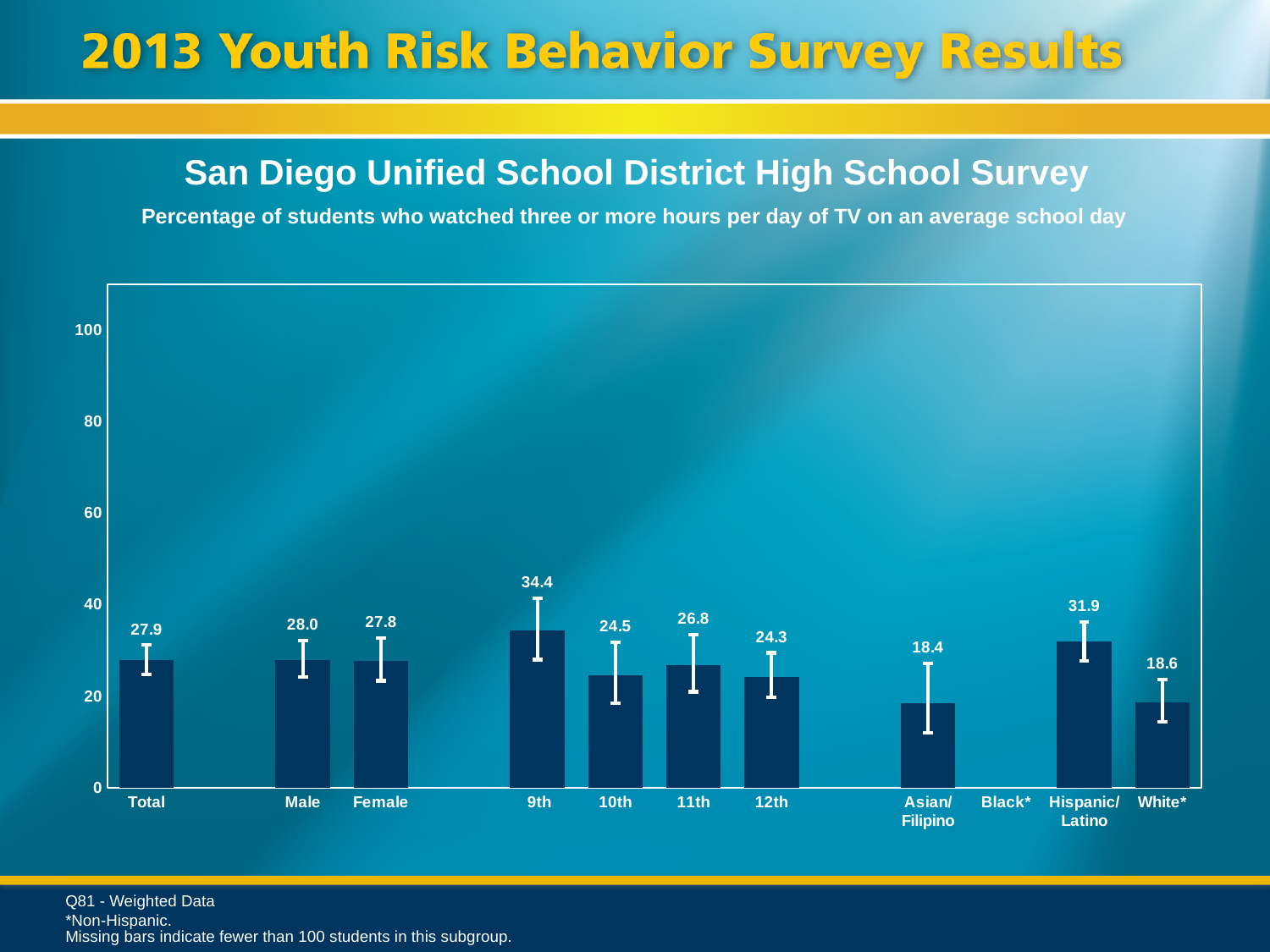
What is the difference between the 9th and 12th grade values? 10.1 Which category label has no bar plotted? Black* What is the difference between the Male and Female values? 0.2 Which category with a plotted bar has the lowest value? Asian/Filipino Which category has the highest value? 9th What is the value for Total? 27.9 Which is larger, the value for 11th grade or the value for 10th grade? 11th What kind of chart is shown? bar chart What is the value for Hispanic/Latino? 31.9 What is the value for 9th grade? 34.4 Is the value for White* greater or less than 20? less What is the value for Asian/Filipino? 18.4